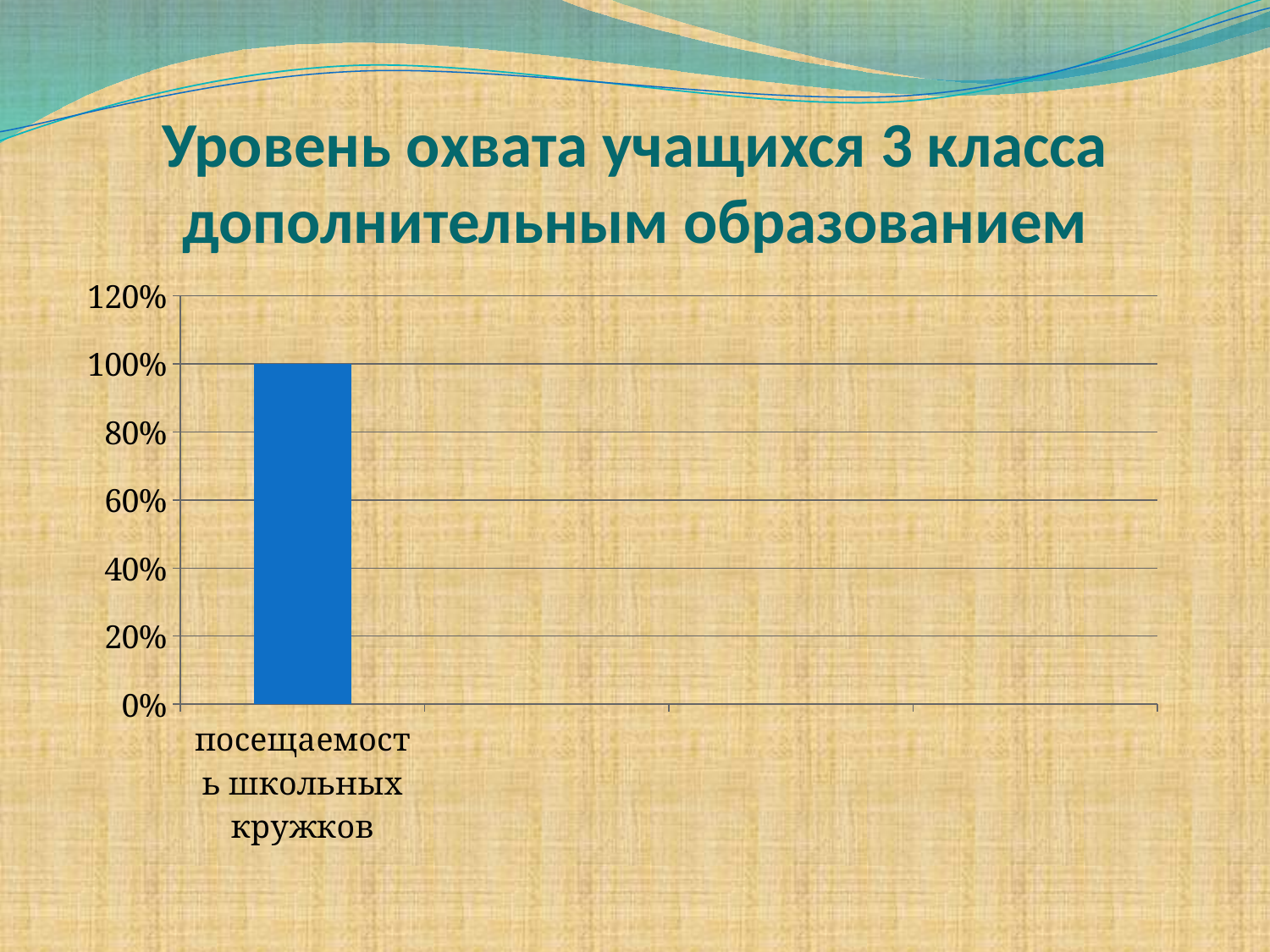
What is the label of the only category shown on the x axis? посещаемость школьных кружков What kind of chart is shown on the slide? bar chart What is the title of the chart on the slide? Уровень охвата учащихся 3 класса дополнительным образованием Is the value for посещаемость школьных кружков greater or less than 120%? less What is the value for посещаемость школьных кружков? 100% How many bars are plotted in the chart? 1 What colour is the bar in the chart? blue Is the value for посещаемость школьных кружков greater or less than 80%? greater